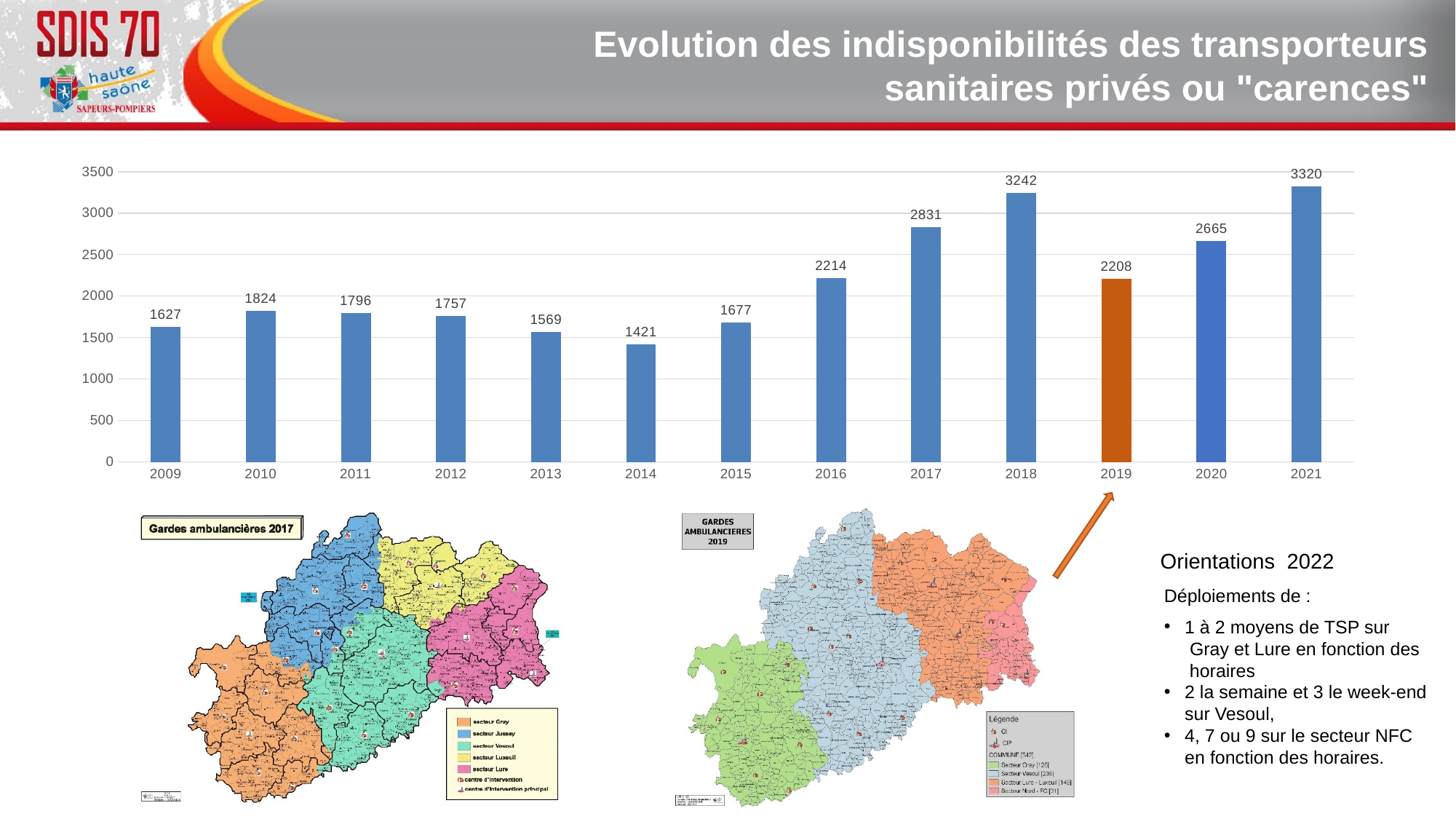
What is the value shown for 2014? 1421 What is the value shown for 2018? 3242 What kind of chart is shown on the slide? bar chart What is the difference between the values for 2018 and 2019? 1034 What is the difference between the values for 2021 and 2020? 655 Which year's bar is coloured orange instead of blue? 2019 Is the value for 2017 greater or less than 2500? greater Which year has the highest value? 2021 Which is larger, the value for 2010 or the value for 2011? 2010 Which year has the lowest value? 2014 What is the value shown for 2019? 2208 How many years are shown on the x axis? 13